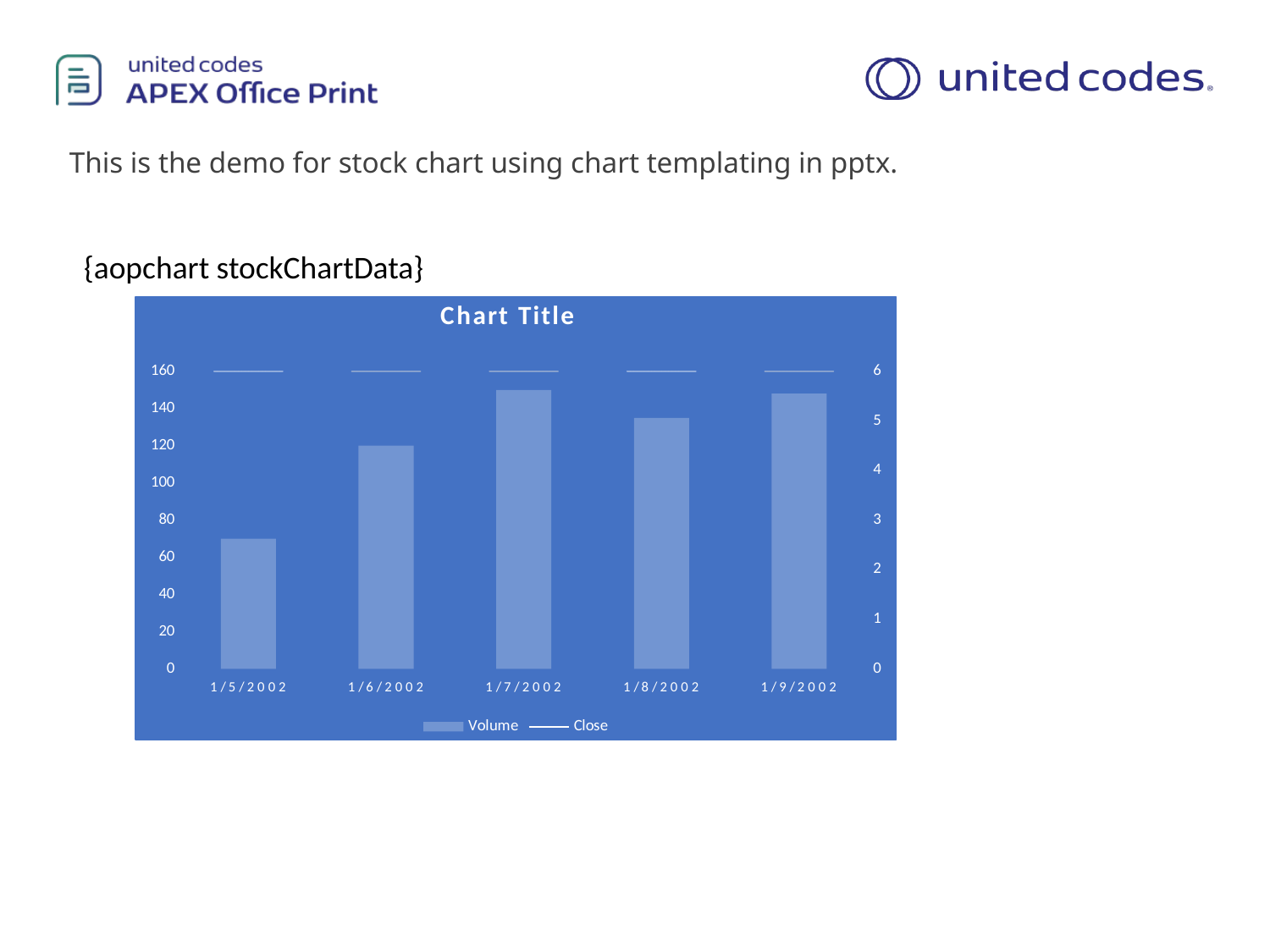
Is the Volume value for 1/7/2002 greater or less than 140? greater Which has the larger Volume, 1/5/2002 or 1/6/2002? 1/6/2002 How many series does the chart legend list? 2 How many dates are shown on the x axis of the chart? 5 Is the Volume value for 1/6/2002 greater or less than 100? greater Which date has the lowest Volume bar? 1/5/2002 Which has the larger Volume, 1/7/2002 or 1/8/2002? 1/7/2002 What are the two series named in the chart legend? Volume and Close What is the title of the chart? Chart Title Is the Volume value for 1/8/2002 greater or less than 120? greater What kind of chart is shown on the slide? bar chart